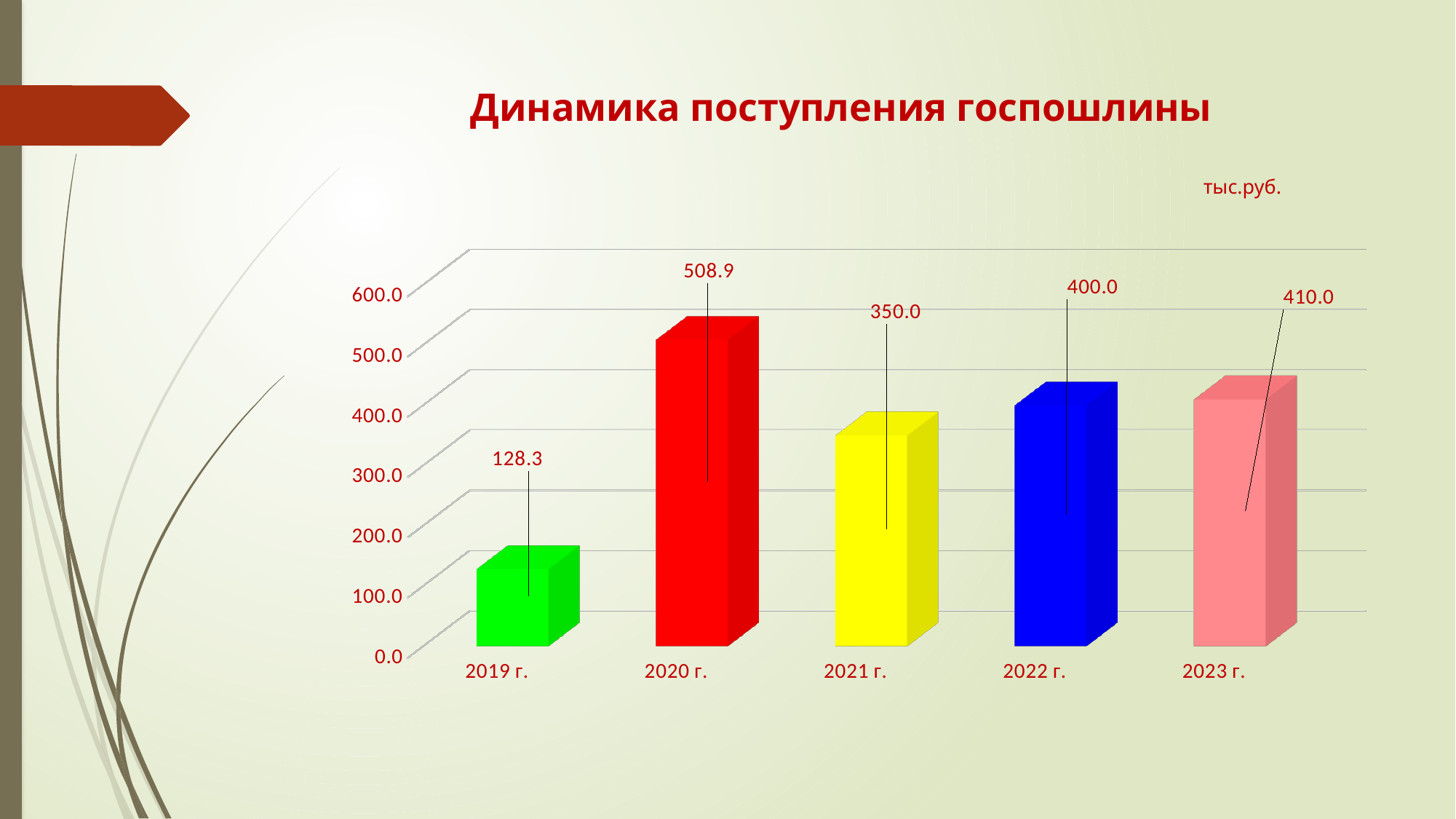
Which year has the highest value? 2020 г. What is the difference between the values for 2020 г. and 2019 г.? 380.6 What kind of chart is shown on the slide? bar chart What is the title of the chart? Динамика поступления госпошлины What is the difference between the values for 2023 г. and 2022 г.? 10.0 How many years are shown on the chart? 5 What is the value for 2023 г.? 410.0 What is the value for 2019 г.? 128.3 Is the value for 2021 г. greater or less than 400.0? less What is the value for 2020 г.? 508.9 Which year has the lowest value? 2019 г. Which is larger, the value for 2021 г. or the value for 2022 г.? 2022 г.